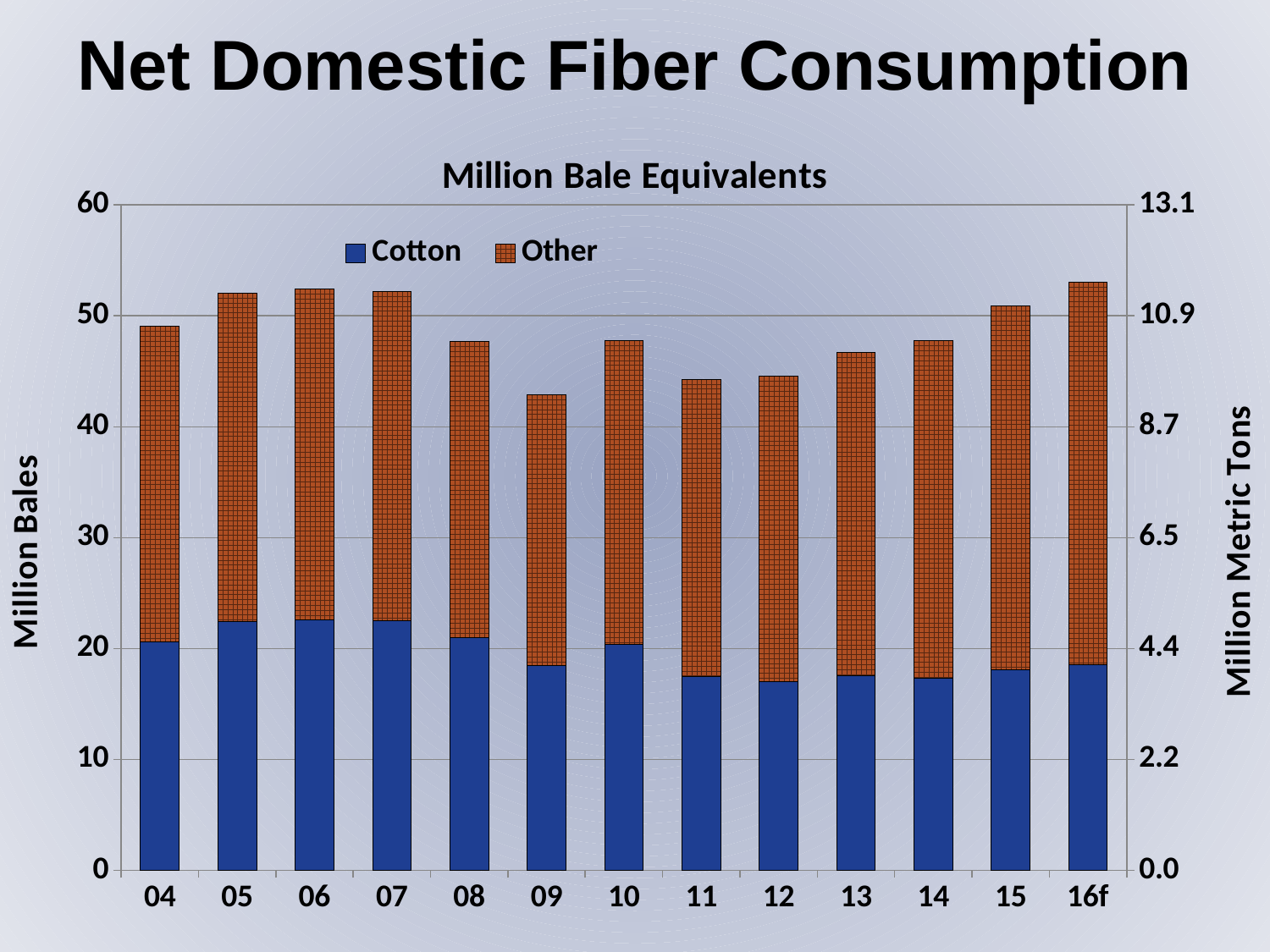
Which year has the lowest total bar? 09 Is the Cotton value for 12 greater or less than 20 million bales? less How many series does the legend list? 2 Which has the larger total bar, 05 or 08? 05 Is the Cotton value for 06 greater or less than 20 million bales? greater Is the total bar height for 09 greater or less than 40 million bales? greater What are the two series named in the legend? Cotton and Other What kind of chart is shown on the slide? stacked bar chart What is the label of the left vertical axis? Million Bales How many years (categories) are shown on the x axis? 13 Do the total bars rise or fall from 12 to 16f? rise